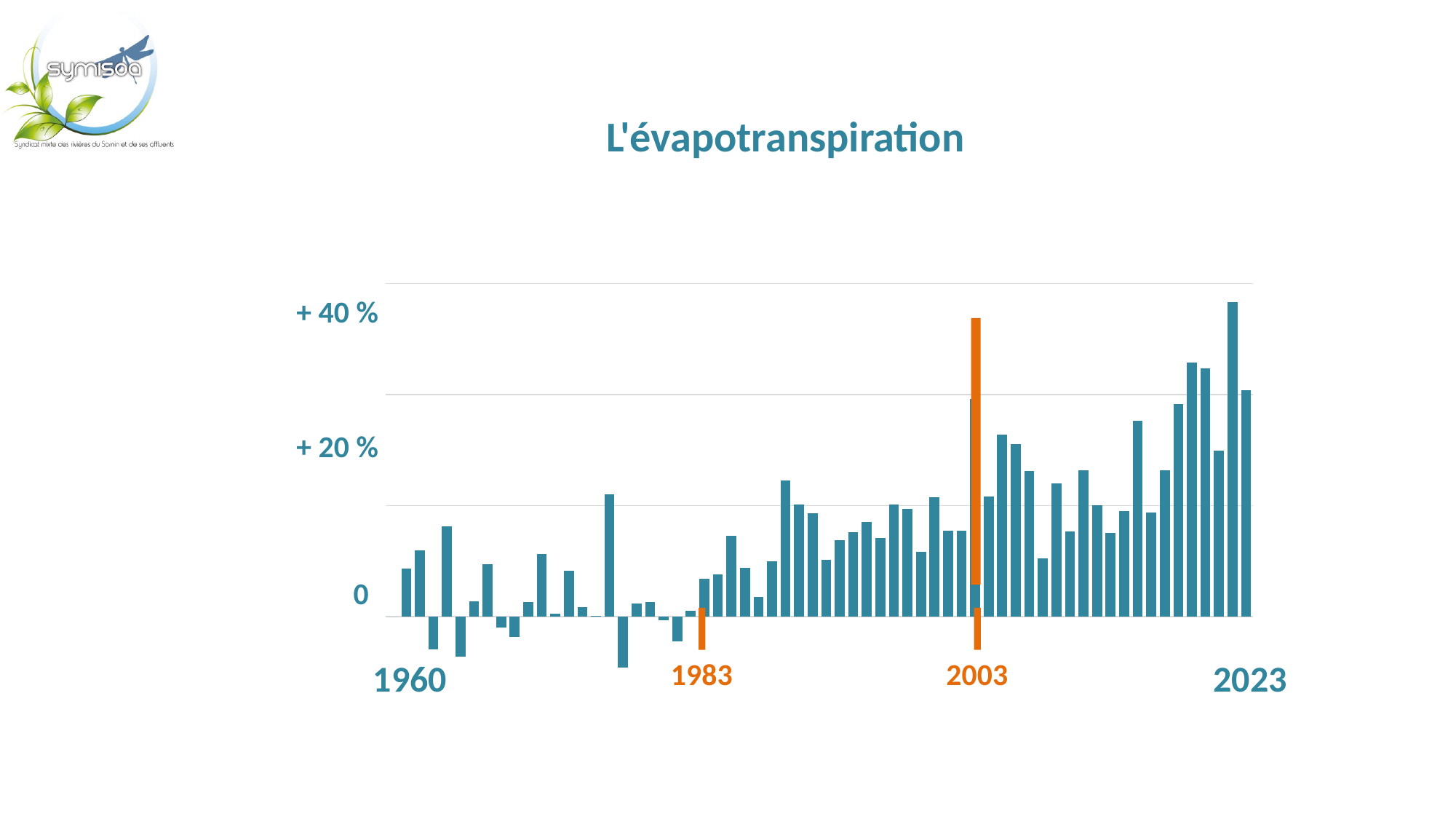
Which has the larger value, 1983 or 2003? 2003 Which year has the highest value? 2022 What is the title of the chart? L'évapotranspiration Overall, do the values rise or fall from 1960 to 2023? rise Is the value for 2003 greater or less than 0? greater Which two years are highlighted with orange bars? 1983 and 2003 Is the value for 2023 greater or less than + 20 %? greater Is the value for 1983 greater or less than 0? greater What kind of chart is shown on the slide? bar chart